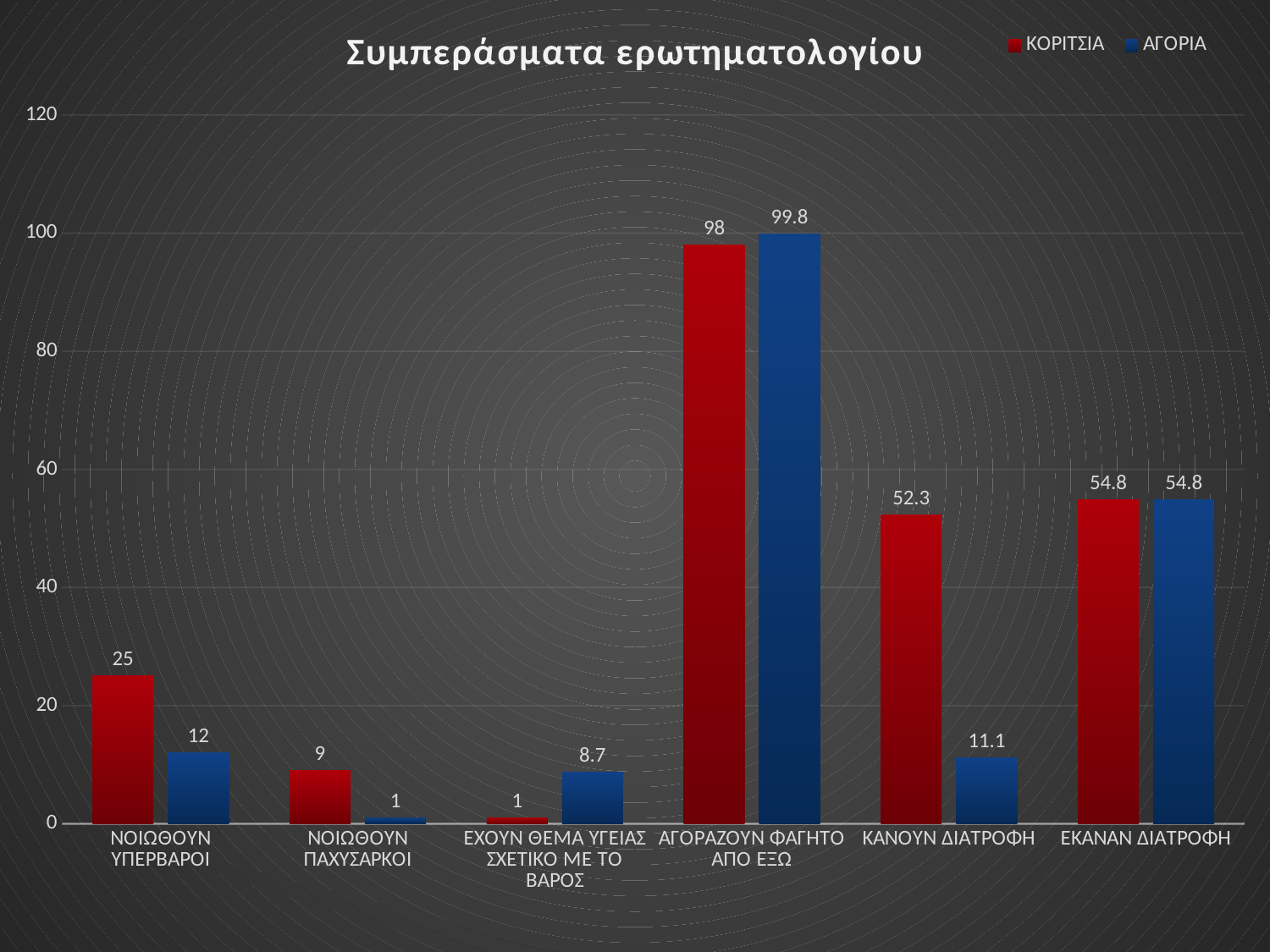
What is the value for ΚΟΡΙΤΣΙΑ in the ΝΟΙΩΘΟΥΝ ΥΠΕΡΒΑΡΟΙ category? 25 What is the title of the chart? Συμπεράσματα ερωτηματολογίου Which category has the lowest value for ΑΓΟΡΙΑ? ΝΟΙΩΘΟΥΝ ΠΑΧΥΣΑΡΚΟΙ What is the difference between ΚΟΡΙΤΣΙΑ and ΑΓΟΡΙΑ in the ΚΑΝΟΥΝ ΔΙΑΤΡΟΦΗ category? 41.2 What is the value for ΑΓΟΡΙΑ in the ΚΑΝΟΥΝ ΔΙΑΤΡΟΦΗ category? 11.1 How many series does the legend list? 2 How many categories are shown on the x axis? 6 Which is larger in the ΝΟΙΩΘΟΥΝ ΥΠΕΡΒΑΡΟΙ category, ΚΟΡΙΤΣΙΑ or ΑΓΟΡΙΑ? ΚΟΡΙΤΣΙΑ Which category has the highest value for ΚΟΡΙΤΣΙΑ? ΑΓΟΡΑΖΟΥΝ ΦΑΓΗΤΟ ΑΠΟ ΕΞΩ What kind of chart is shown on the slide? bar chart What is the value for ΑΓΟΡΙΑ in the ΑΓΟΡΑΖΟΥΝ ΦΑΓΗΤΟ ΑΠΟ ΕΞΩ category? 99.8 Is the value for ΚΟΡΙΤΣΙΑ in the ΕΚΑΝΑΝ ΔΙΑΤΡΟΦΗ category greater or less than 40? greater